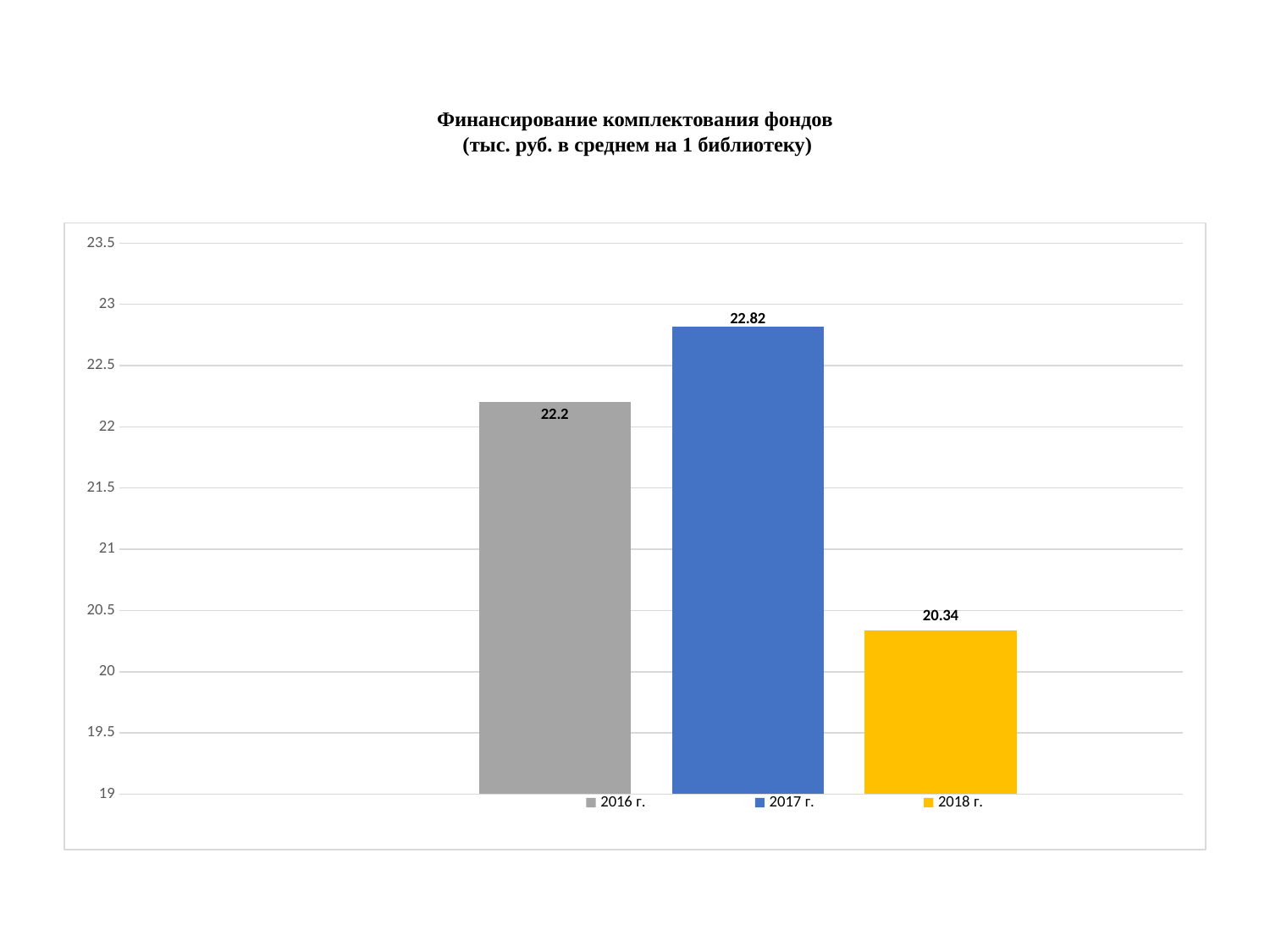
What is the difference between the values for 2017 г. and 2016 г.? 0.62 What is the value for 2016 г.? 22.2 What colour is the bar for 2017 г.? blue Which is larger, the value for 2016 г. or the value for 2018 г.? 2016 г. What kind of chart is shown on the slide? bar chart Is the value for 2018 г. greater or less than 21? less Which year has the lowest value? 2018 г. What is the difference between the values for 2016 г. and 2018 г.? 1.86 How many bars are shown in the chart? 3 What is the value for 2018 г.? 20.34 Which year has the highest value? 2017 г. What is the value for 2017 г.? 22.82